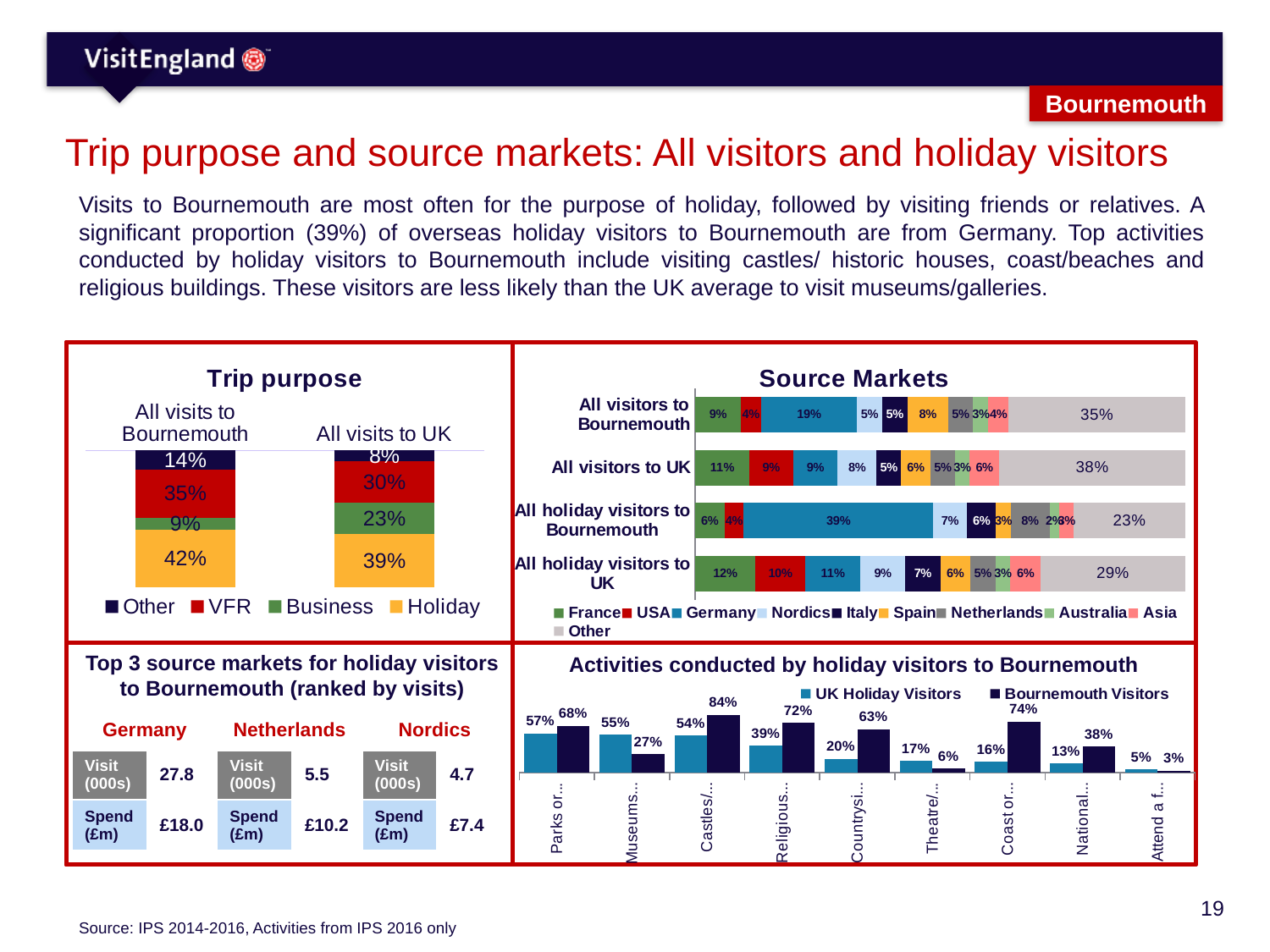
How many series does the legend of the Source Markets chart list? 10 In the Activities chart, which activity has the highest value for UK Holiday Visitors? Parks In the Activities chart, what percentage of Bournemouth Visitors visit castles? 84% In the Trip purpose chart, what is the difference between the Business share for all visits to the UK and for all visits to Bournemouth? 14% How many series does the legend of the Trip purpose chart list? 4 In the Activities chart, which is larger for museums: UK Holiday Visitors or Bournemouth Visitors? UK Holiday Visitors In the Trip purpose chart, what is the VFR share for all visits to the UK? 30% In the Source Markets chart, what share of all holiday visitors to Bournemouth come from Germany? 39% What type of chart is the Activities conducted by holiday visitors to Bournemouth chart? Bar chart In the Trip purpose chart, what percentage of all visits to Bournemouth are for Holiday? 42% In the Source Markets chart, which category has the largest Germany share? All holiday visitors to Bournemouth In the Source Markets chart, what is the Other share for all visitors to the UK? 38%